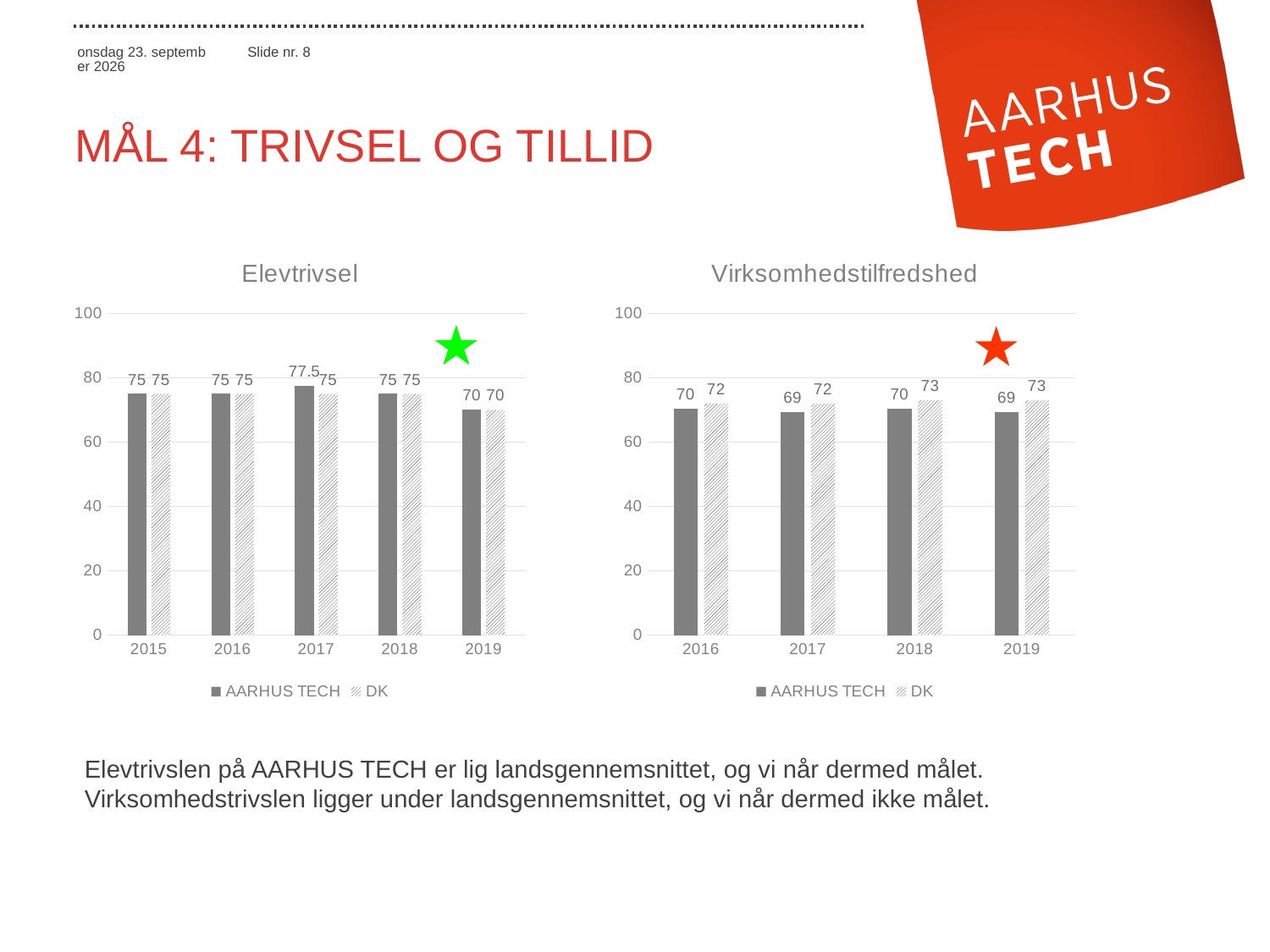
In the Virksomhedstilfredshed chart, what is the difference between the DK and AARHUS TECH values in 2019? 4 How many series does the legend of the Virksomhedstilfredshed chart list? 2 In the Elevtrivsel chart, what is the difference between the AARHUS TECH and DK values in 2017? 2.5 How many years are shown on the x axis of the Elevtrivsel chart? 5 In the Elevtrivsel chart, which year has the highest AARHUS TECH value? 2017 In the Virksomhedstilfredshed chart, what is the AARHUS TECH value for 2019? 69 In the Virksomhedstilfredshed chart, which is larger in 2017, the AARHUS TECH value or the DK value? DK In the Elevtrivsel chart, what is the DK value for 2019? 70 In the Virksomhedstilfredshed chart, what is the DK value for 2018? 73 In the Elevtrivsel chart, what is the AARHUS TECH value for 2017? 77.5 What are the two series named in the legend of the Elevtrivsel chart? AARHUS TECH and DK What kind of chart is the Elevtrivsel chart? Bar chart